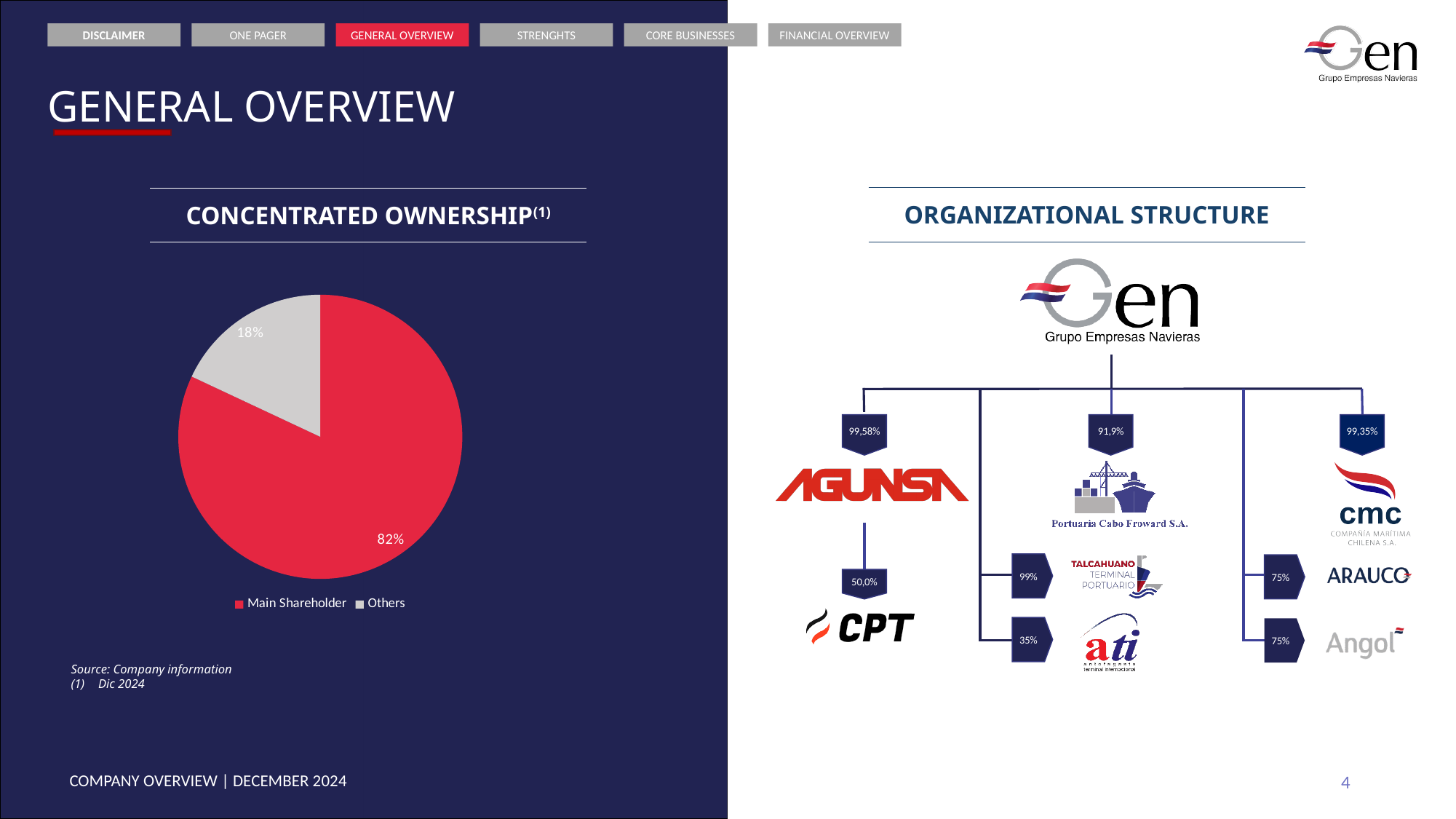
What colour is the Main Shareholder slice in the Concentrated Ownership pie chart? Red What type of chart is shown under the heading Concentrated Ownership? Pie chart How many slices does the Concentrated Ownership pie chart have? 2 In the Concentrated Ownership pie chart, by how many percentage points does the Main Shareholder's share exceed that of Others? 64 percentage points In the Concentrated Ownership pie chart, what share is held by Others? 18% In the Concentrated Ownership pie chart, what share is held by the Main Shareholder? 82% What is the title of the pie chart on the left side of the slide? Concentrated Ownership Which category has the largest slice in the Concentrated Ownership pie chart? Main Shareholder Which category has the smallest slice in the Concentrated Ownership pie chart? Others What share of the Concentrated Ownership pie does the Others slice represent? 18% How many entries does the legend of the Concentrated Ownership pie chart list? 2 In the Concentrated Ownership pie chart, which is larger: the Main Shareholder slice or the Others slice? Main Shareholder